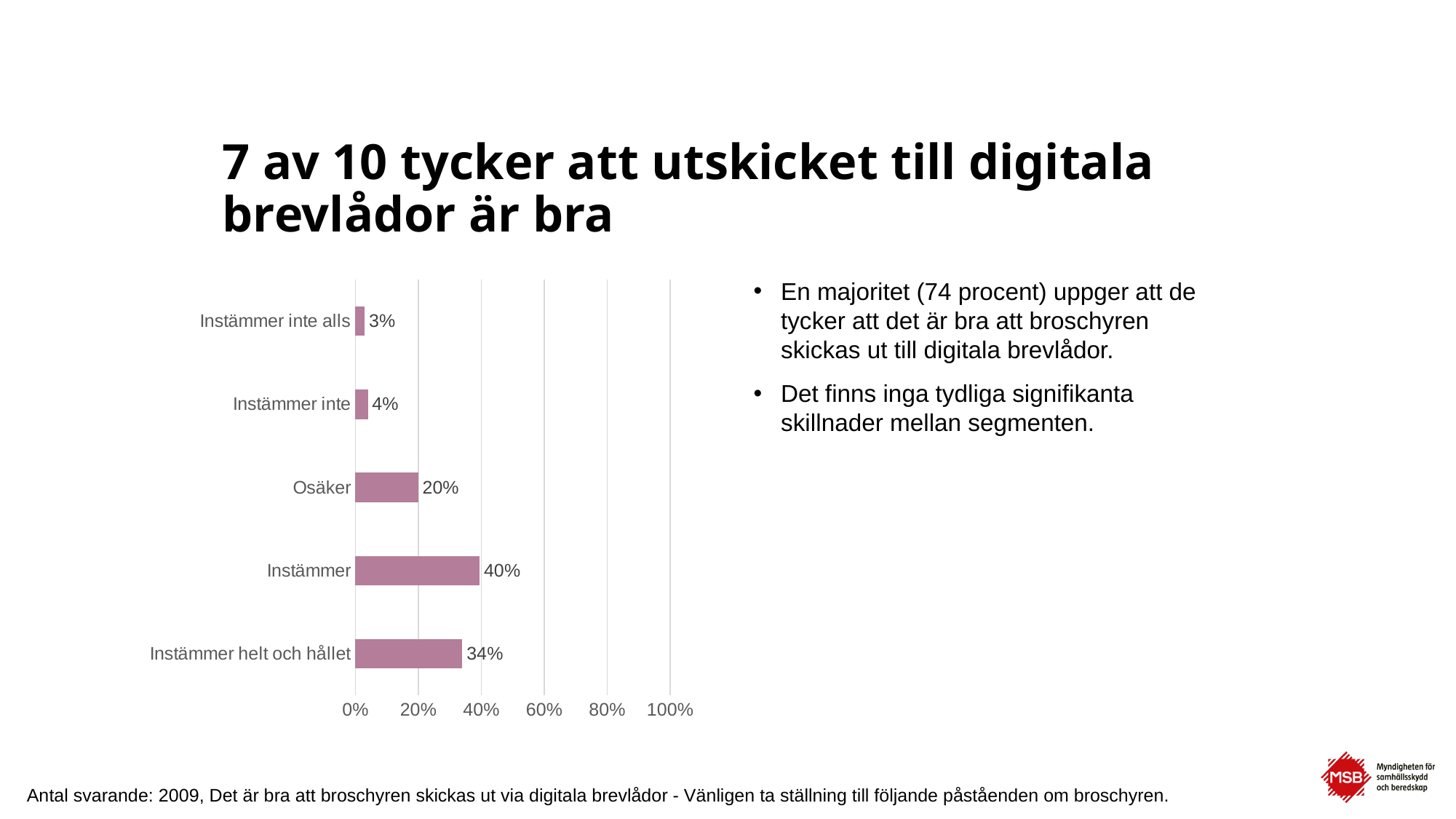
Which is larger, the value for "Osäker" or the value for "Instämmer inte"? Osäker What is the value for "Osäker"? 20% What is the value for "Instämmer helt och hållet"? 34% How many categories are shown in the chart? 5 What kind of chart is shown on the slide? Bar chart Which category has the highest value? Instämmer Which category has the lowest value? Instämmer inte alls What is the value for "Instämmer inte alls"? 3% What is the difference between the values for "Instämmer" and "Instämmer helt och hållet"? 6% Is the value for "Instämmer" greater or less than 20%? greater What is the total of the values for "Instämmer" and "Instämmer helt och hållet"? 74% What is the value for "Instämmer"? 40%